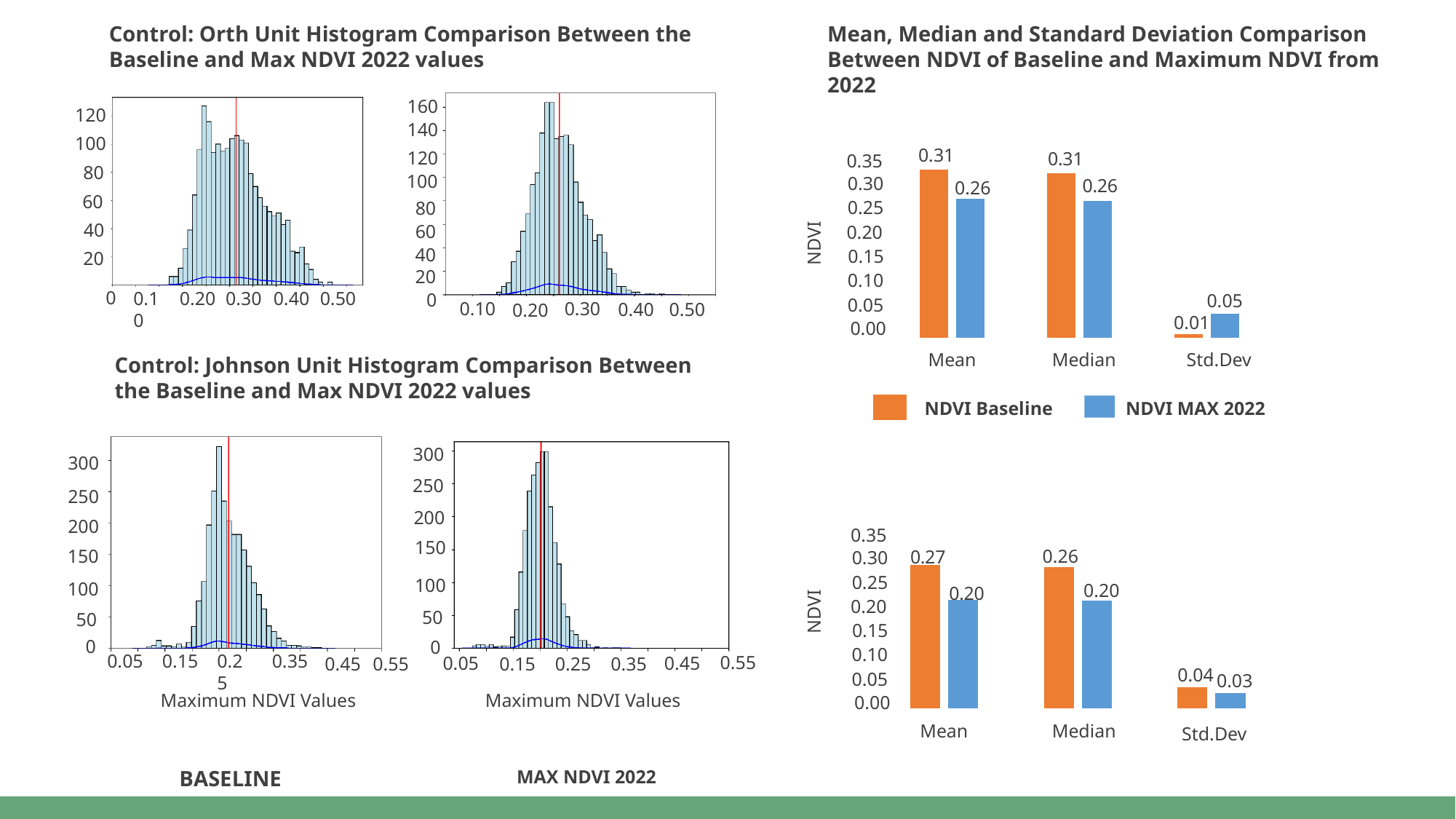
How many categories are shown on the x axis of the lower bar chart on the right? 3 In the upper bar chart on the right (Mean, Median and Standard Deviation Comparison), what is the Mean value for NDVI Baseline? 0.31 In the upper bar chart on the right, which series has the larger Std.Dev value, NDVI Baseline or NDVI MAX 2022? NDVI MAX 2022 What kind of chart is the upper chart on the right titled 'Mean, Median and Standard Deviation Comparison Between NDVI of Baseline and Maximum NDVI from 2022'? bar chart In the upper bar chart on the right, what is the Std.Dev value for NDVI MAX 2022? 0.05 In the lower bar chart on the right, what is the difference between the Mean values of NDVI Baseline and NDVI MAX 2022? 0.07 In the upper bar chart on the right, what is the difference between the Median values of NDVI Baseline and NDVI MAX 2022? 0.05 In the lower bar chart on the right, which category has the lowest NDVI MAX 2022 value? Std.Dev In the lower bar chart on the right, what is the Median value for NDVI Baseline? 0.26 In the lower bar chart on the right, what is the Mean value for NDVI MAX 2022? 0.20 How many series does the legend of the upper bar chart on the right list? 2 In the upper bar chart on the right, which colour represents NDVI Baseline? orange